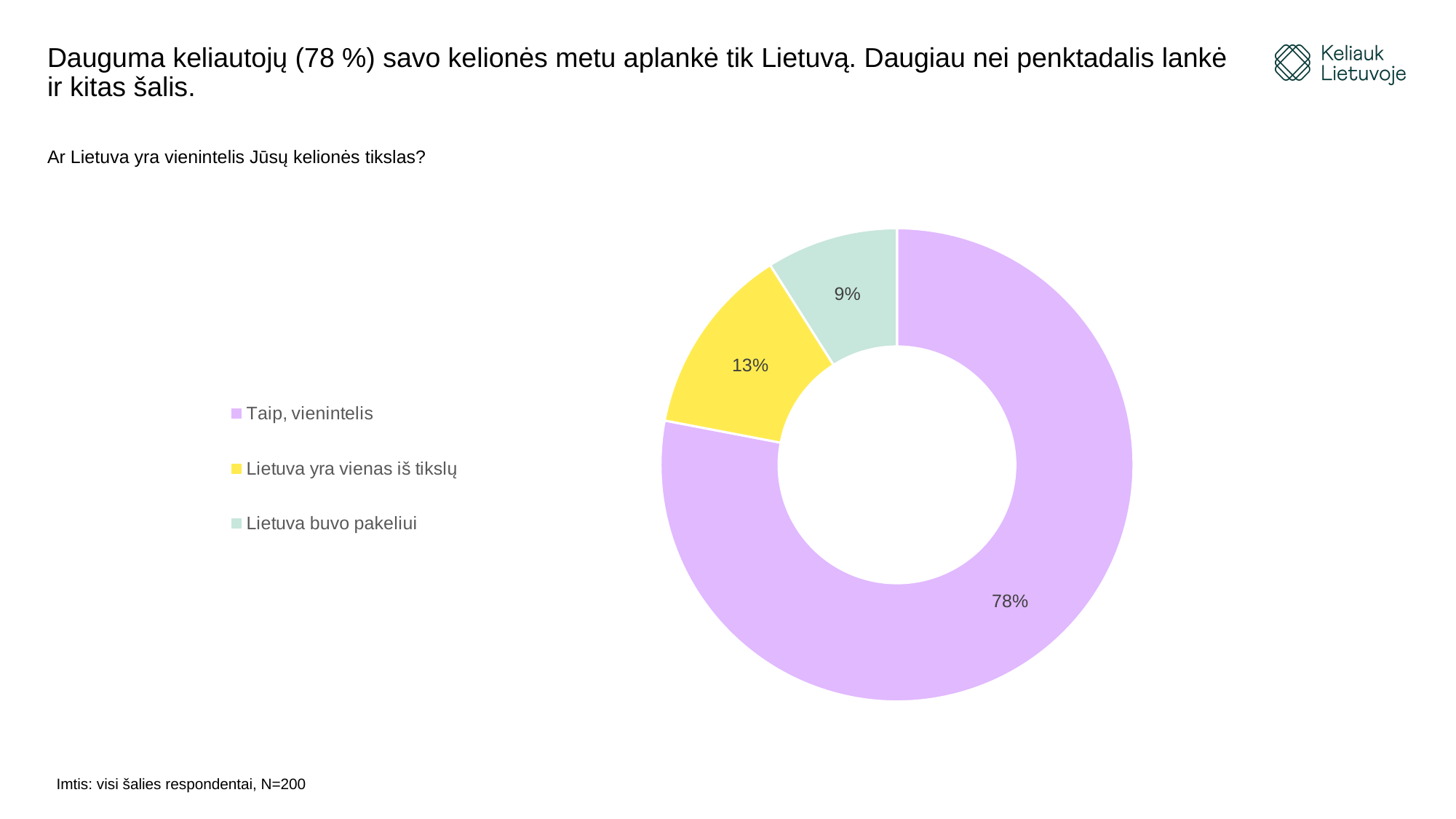
Which answer has the smallest share of the pie? Lietuva buvo pakeliui Which answer has the largest share of the pie? Taip, vienintelis What is the difference in percentage points between "Lietuva yra vienas iš tikslų" and "Lietuva buvo pakeliui"? 4 What share of respondents answered "Lietuva buvo pakeliui"? 9% Which is larger: the share for "Lietuva yra vienas iš tikslų" or for "Lietuva buvo pakeliui"? Lietuva yra vienas iš tikslų What question is the chart based on, as written above it? Ar Lietuva yra vienintelis Jūsų kelionės tikslas? What is the difference in percentage points between "Taip, vienintelis" and "Lietuva yra vienas iš tikslų"? 65 What share of respondents answered "Lietuva yra vienas iš tikslų"? 13% How many categories does the pie chart show? 3 What kind of chart is shown on the slide? Pie chart (doughnut) What colour is the slice for "Lietuva yra vienas iš tikslų"? Yellow What share of respondents answered "Taip, vienintelis"? 78%